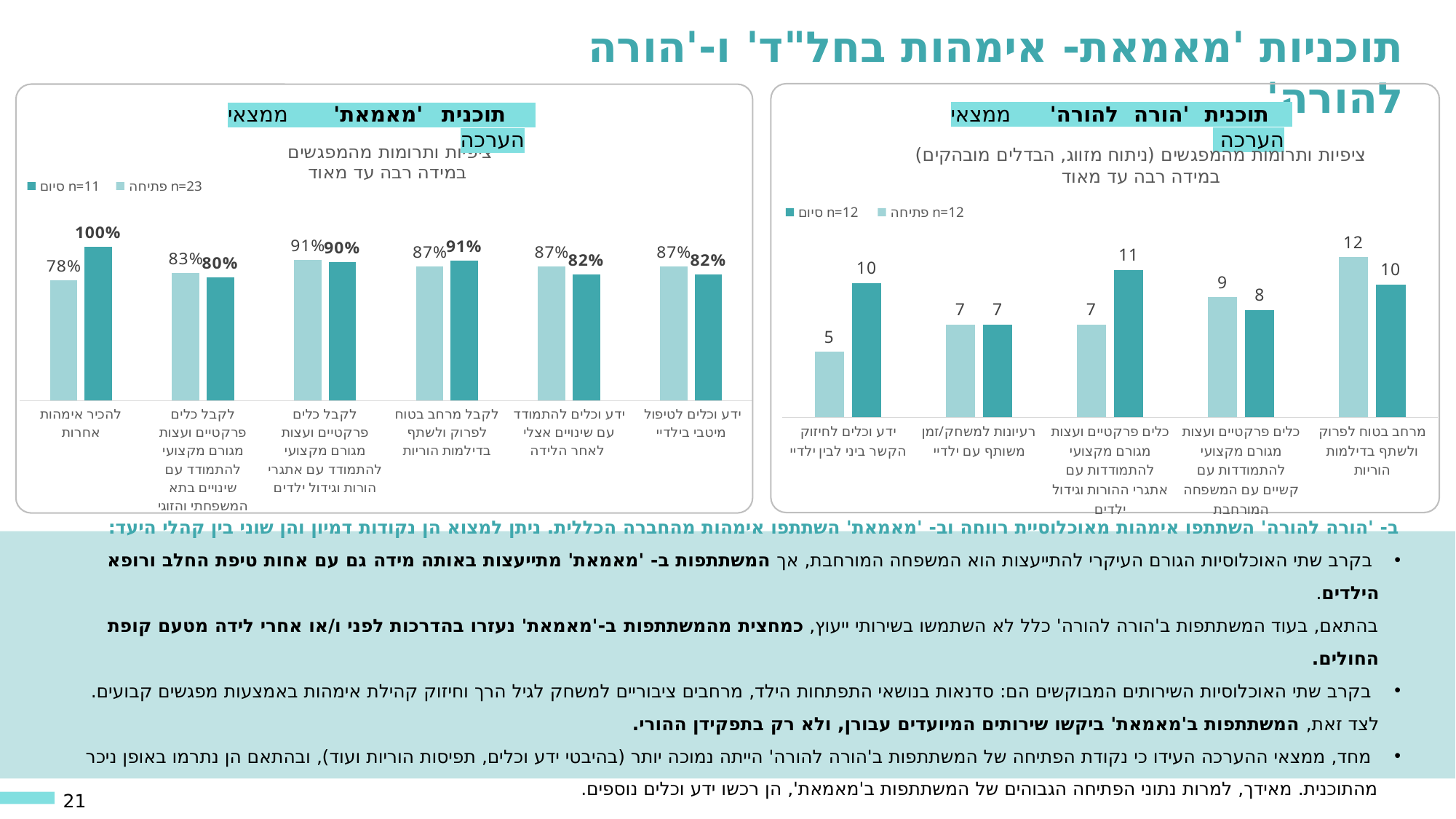
In the 'מאמאת' chart (left), what is the סיום value for 'להכיר אימהות אחרות'? 100% In the 'הורה להורה' chart (right), is the פתיחה value or the סיום value larger for 'מרחב בטוח לפרוק ולשתף בדילמות הוריות'? פתיחה In the 'הורה להורה' chart (right), which category has the highest פתיחה value? מרחב בטוח לפרוק ולשתף בדילמות הוריות In the 'מאמאת' chart (left), what is the פתיחה value for 'להכיר אימהות אחרות'? 78% In the 'הורה להורה' chart (right), what is the פתיחה value for 'ידע וכלים לחיזוק הקשר ביני לבין ילדיי'? 5 In the 'מאמאת' chart (left), which category has the highest סיום value? להכיר אימהות אחרות In the 'הורה להורה' chart (right), how many categories are shown? 5 In the 'הורה להורה' chart (right), which category has the lowest פתיחה value? ידע וכלים לחיזוק הקשר ביני לבין ילדיי In the 'הורה להורה' chart (right), what is the סיום value for 'כלים פרקטיים ועצות מגורם מקצועי להתמודדות עם אתגרי ההורות וגידול ילדים'? 11 In the 'מאמאת' chart (left), what sample size does the legend give for פתיחה? n=23 In the 'מאמאת' chart (left), what is the difference between the סיום and פתיחה values for 'להכיר אימהות אחרות'? 22% What type of chart is the 'מאמאת' chart on the left? Bar chart